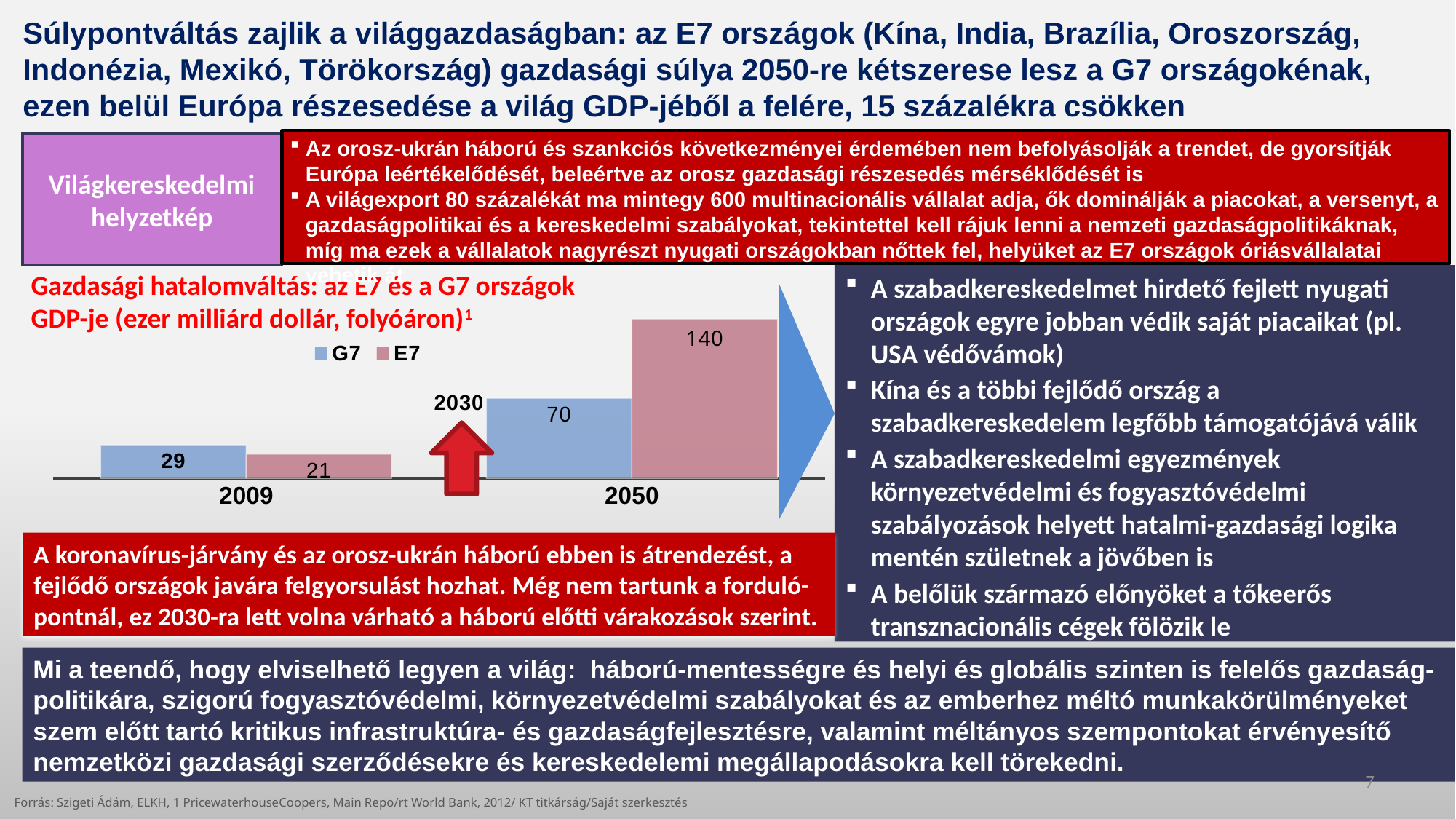
What is the value for E7 in 2009? 21 Which series has the highest value in 2050? E7 How many series does the legend list? 2 What is the value for G7 in 2009? 29 What is the value for G7 in 2050? 70 What is the value for E7 in 2050? 140 Which series has the lowest value in 2009? E7 What is the difference between the G7 and E7 values in 2009? 8 Does the E7 value rise or fall from 2009 to 2050? Rise What kind of chart is shown on the slide? Bar chart What is the difference between the E7 and G7 values in 2050? 70 Which is larger in 2009, G7 or E7? G7